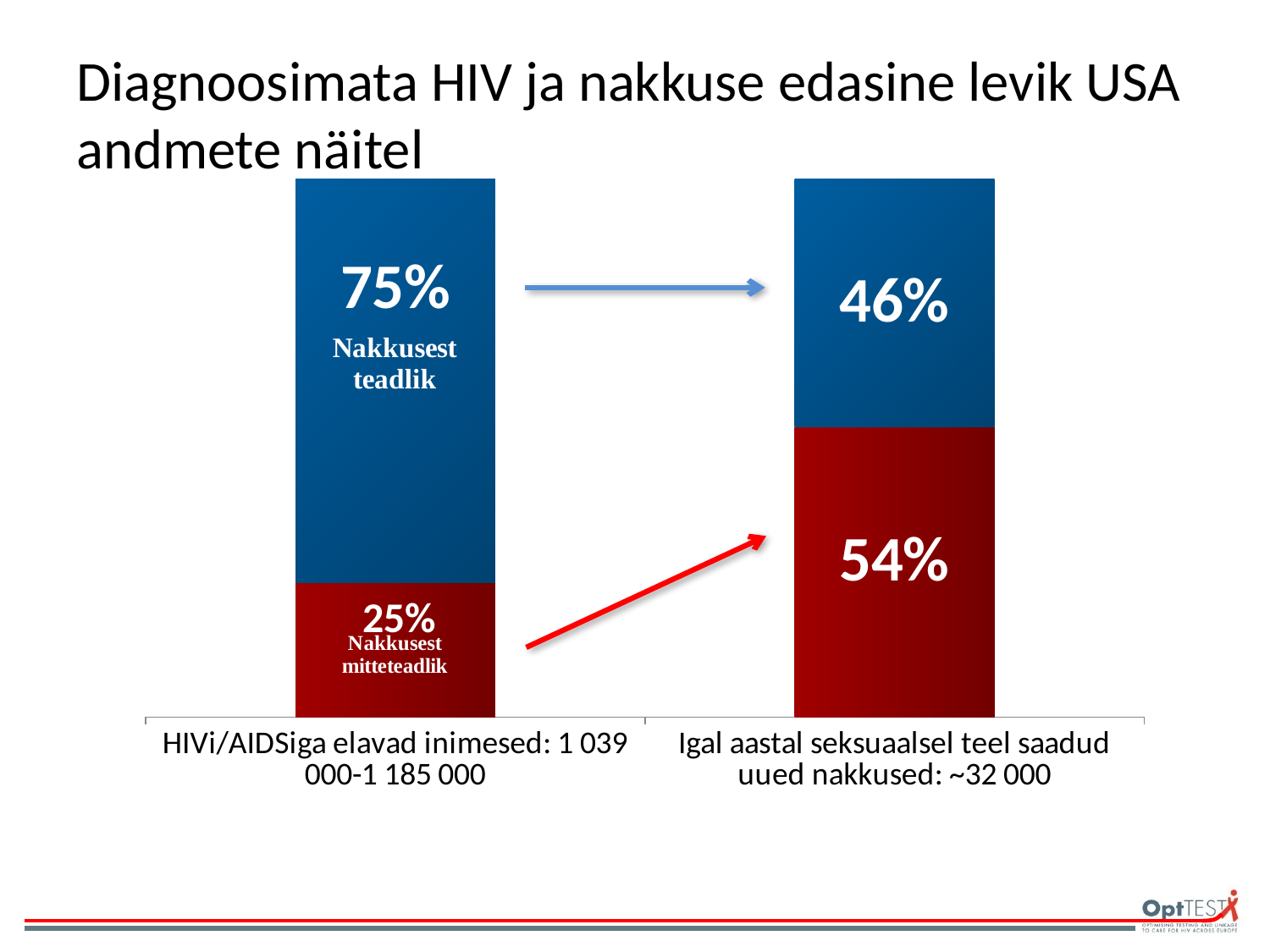
What is the value of the 'Nakkusest teadlik' segment for the 'HIVi/AIDSiga elavad inimesed' bar? 75% What is the total of the two segments in the 'Igal aastal seksuaalsel teel saadud uued nakkused' bar? 100% How many bars (categories) are shown in the chart? 2 Which bar has the larger 'Nakkusest mitteteadlik' segment? Igal aastal seksuaalsel teel saadud uued nakkused: ~32 000 Which bar has the larger 'Nakkusest teadlik' segment? HIVi/AIDSiga elavad inimesed: 1 039 000-1 185 000 What is the difference between the 'Nakkusest mitteteadlik' values of the two bars (54% and 25%)? 29% What is the value of the 'Nakkusest mitteteadlik' segment for the 'HIVi/AIDSiga elavad inimesed' bar? 25% What kind of chart is shown on the slide? stacked bar chart What is the value of the blue (Nakkusest teadlik) segment for the 'Igal aastal seksuaalsel teel saadud uued nakkused' bar? 46% Which colour represents the 'Nakkusest mitteteadlik' segment? red What is the difference between the 'Nakkusest teadlik' values of the two bars (75% and 46%)? 29% What is the value of the red (Nakkusest mitteteadlik) segment for the 'Igal aastal seksuaalsel teel saadud uued nakkused' bar? 54%